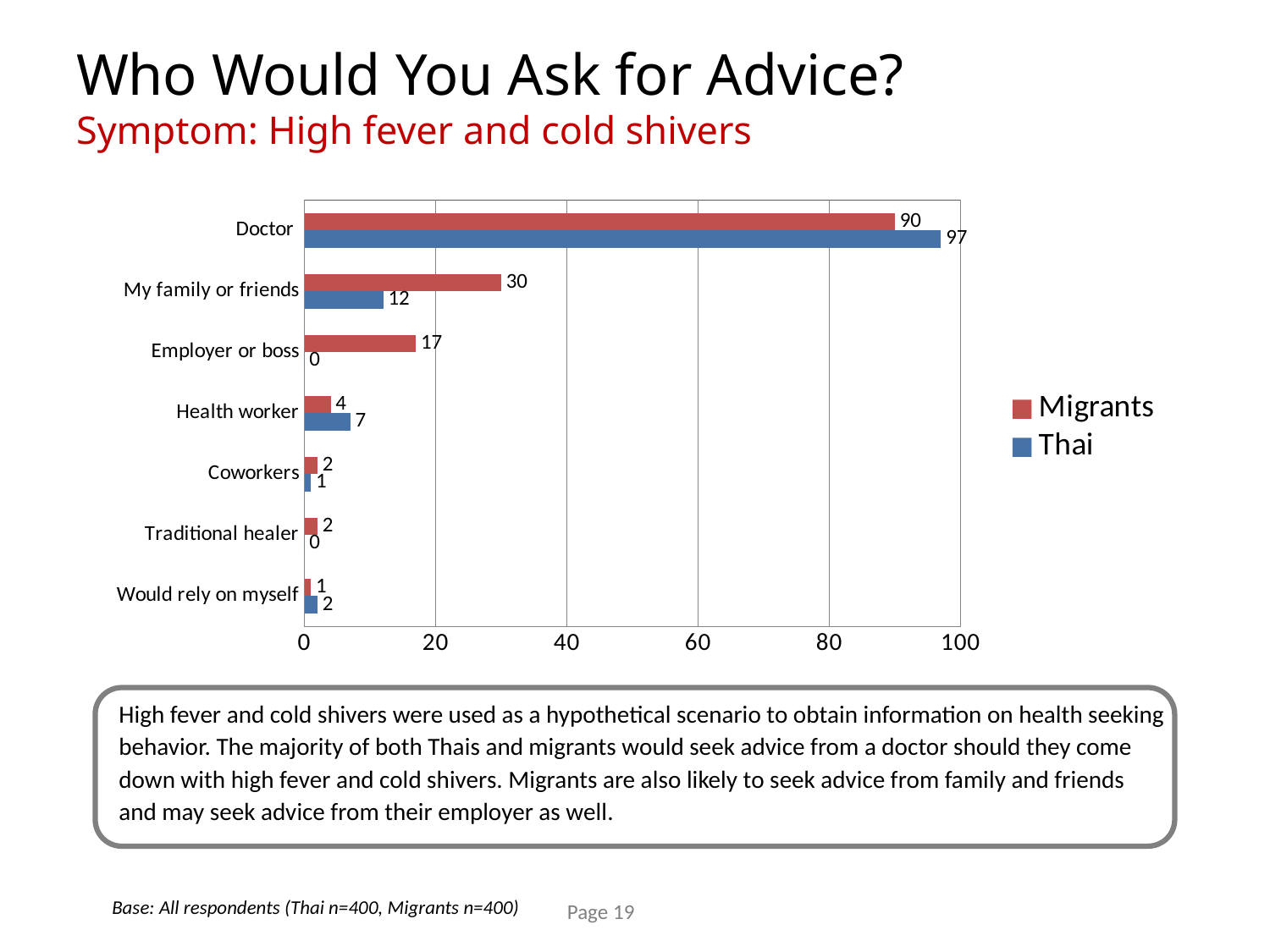
How many categories are shown on the chart? 7 Which category has the highest value for Thai? Doctor How many series does the legend list? 2 Which colour represents the Migrants series? Red What is the value for Thai for Employer or boss? 0 Which category has the lowest value for Migrants? Would rely on myself What is the difference between the Thai and Migrants values for Doctor? 7 What is the value for Migrants for Doctor? 90 What is the value for Thai for My family or friends? 12 Which is larger for Health worker, the Migrants value or the Thai value? Thai What is the difference between the Migrants and Thai values for My family or friends? 18 What kind of chart is shown on the slide? Bar chart